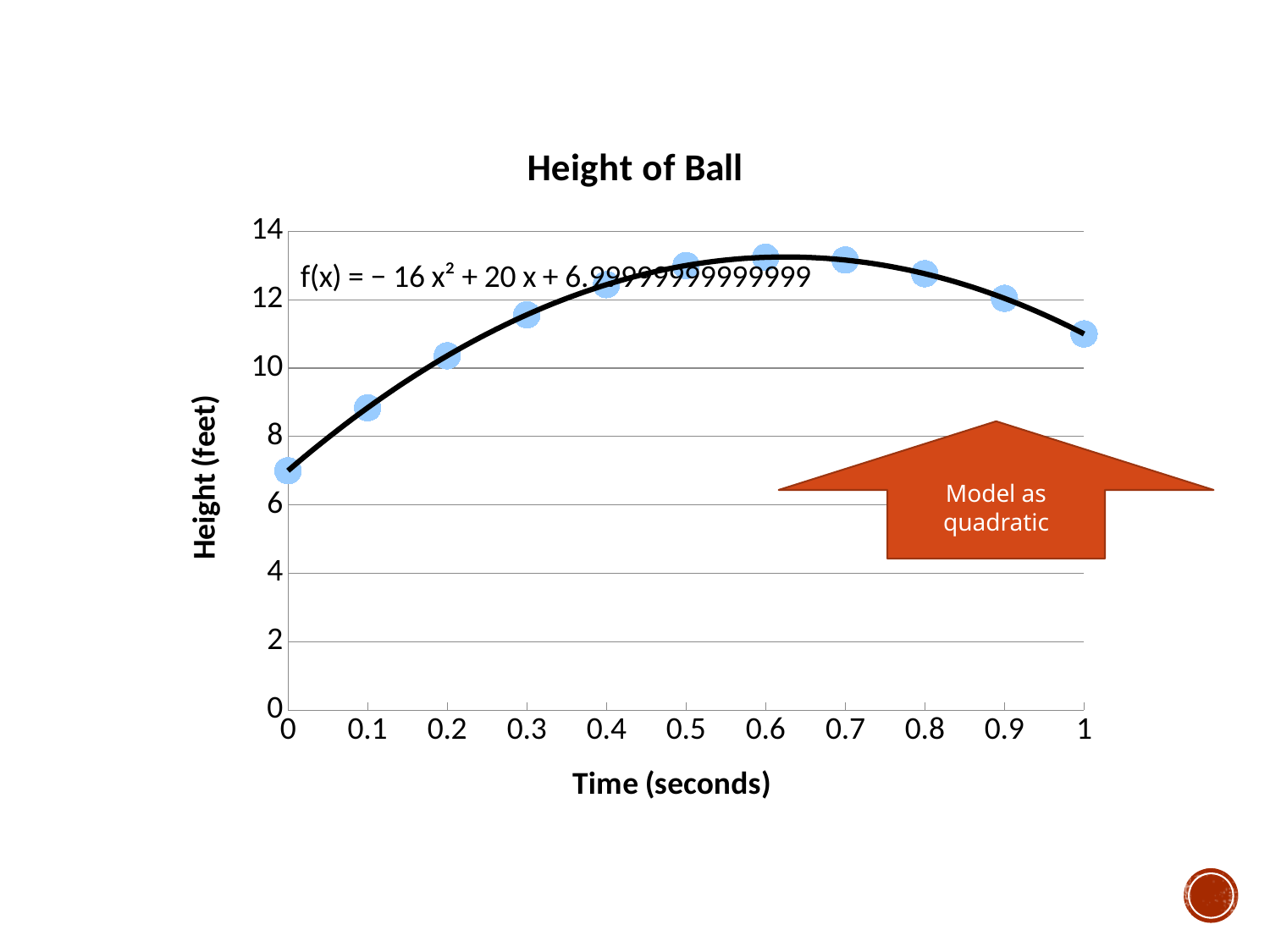
Is the height at time 0.1 greater or less than 10? less At which time value is the plotted height lowest? 0 How does the height change as time increases from 0 to 1? It rises, then falls Is the height at time 0.6 greater or less than 12? greater What kind of chart is shown on the slide? Scatter chart What is the title of the chart? Height of Ball What is the label of the vertical axis? Height (feet) How many data points are plotted on the chart? 11 Which has the greater height, time 0.3 or time 0.5? 0.5 Which has the greater height, time 0.1 or time 0.9? 0.9 Is the height at time 0 greater or less than 8? less